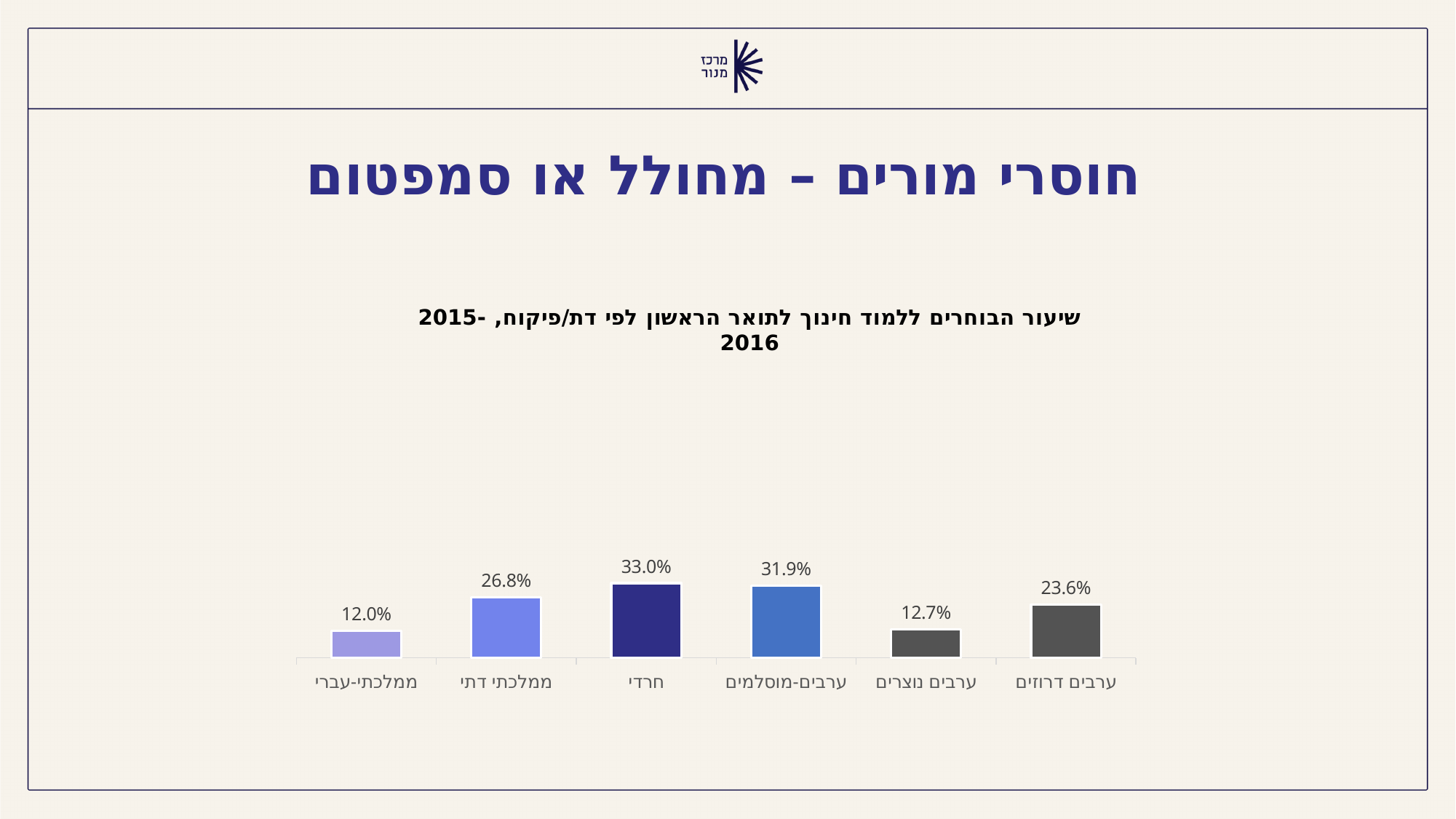
How many categories are shown in the chart? 6 What is the difference between the values for חרדי and ערבים-מוסלמים? 1.1% What is the value for חרדי? 33.0% Which is larger, the value for ערבים דרוזים or the value for ערבים נוצרים? ערבים דרוזים Which category has the highest value? חרדי What kind of chart is shown on the slide? bar chart What is the value for ערבים דרוזים? 23.6% What is the value for ממלכתי-עברי? 12.0% What years does the chart title say the data covers? 2015-2016 What is the value for ממלכתי דתי? 26.8% What is the difference between the values for ממלכתי דתי and ממלכתי-עברי? 14.8% What is the value for ערבים נוצרים? 12.7%